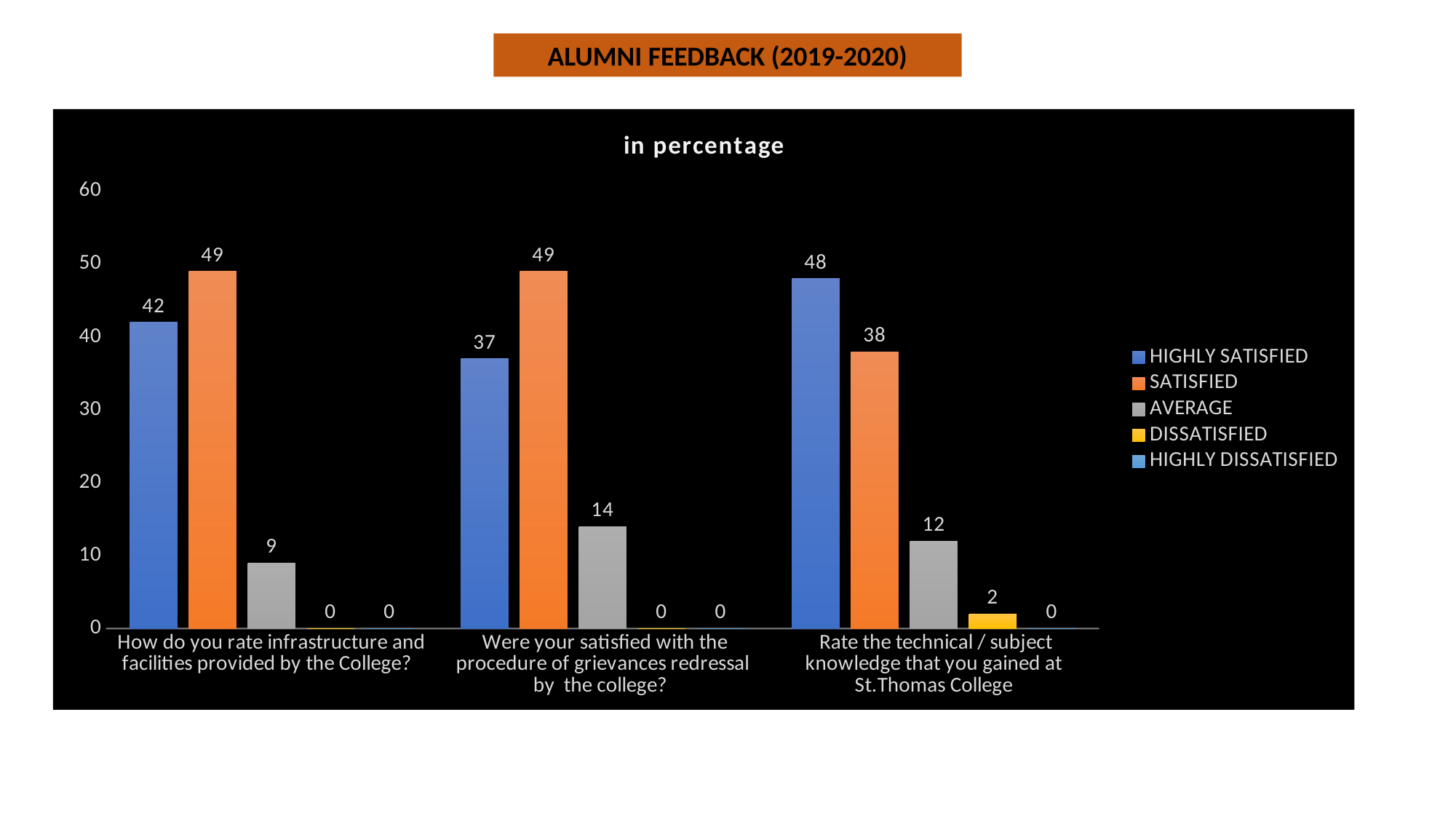
What is the difference between the SATISFIED and HIGHLY SATISFIED values for the question about infrastructure and facilities? 7 For which question is the AVERAGE value the lowest? How do you rate infrastructure and facilities provided by the College? What is the DISSATISFIED value for the question about technical / subject knowledge gained at St.Thomas College? 2 What is the SATISFIED value for the question about technical / subject knowledge gained at St.Thomas College? 38 What is the title shown inside the chart area? in percentage What is the AVERAGE value for the question about the procedure of grievances redressal by the college? 14 For which question is the HIGHLY SATISFIED value the highest? Rate the technical / subject knowledge that you gained at St.Thomas College For the question about technical / subject knowledge, which is larger: HIGHLY SATISFIED or SATISFIED? HIGHLY SATISFIED What kind of chart is shown on the slide? Bar chart How many questions (categories) are shown on the x axis? 3 How many series does the legend list? 5 What is the HIGHLY SATISFIED value for the question about infrastructure and facilities provided by the College? 42